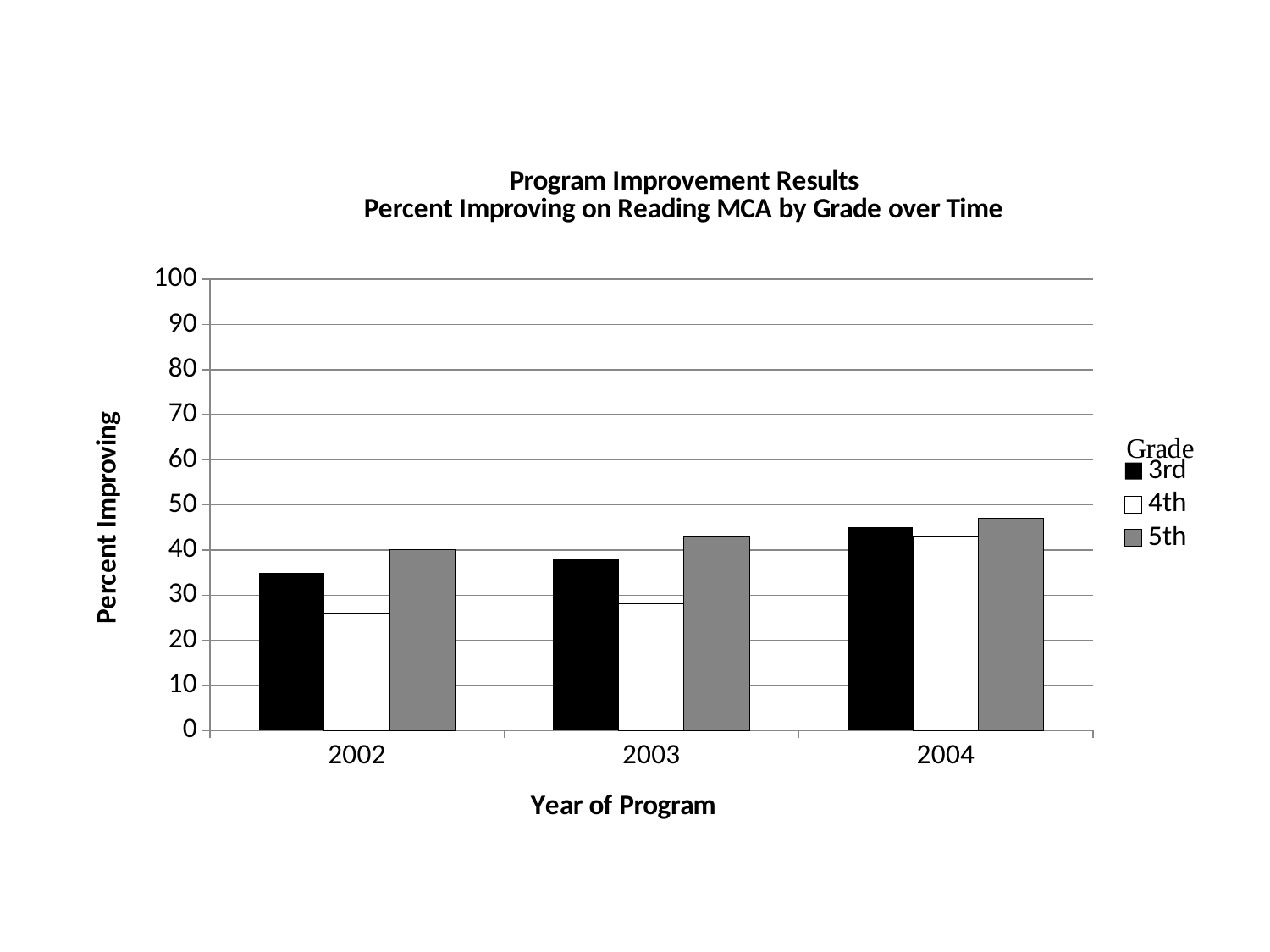
Is the value for 3rd grade in 2002 greater or less than 40? less Is the value for 5th grade in 2004 greater or less than 40? greater Is the value for 4th grade in 2003 greater or less than 40? less How many years are shown on the x axis? 3 In 2002, which grade has the lowest percent improving? 4th What is the title of the y axis? Percent Improving Do the values for 3rd grade rise or fall from 2002 to 2004? rise In 2002, which is larger: the value for 3rd grade or 4th grade? 3rd grade How many series does the legend list? 3 In 2003, which is larger: the value for 5th grade or 4th grade? 5th grade What kind of chart is shown on the slide? bar chart